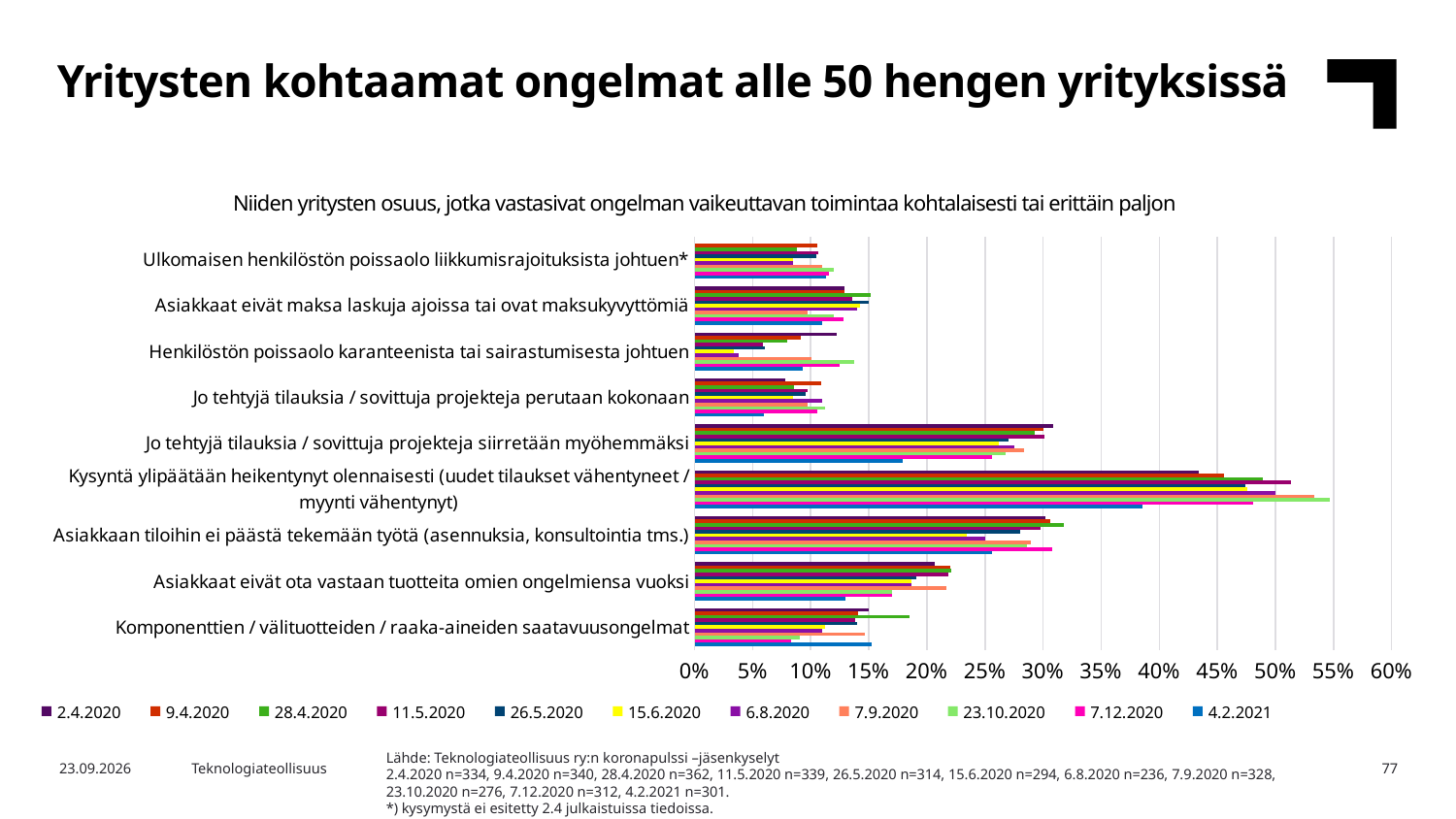
Is the value for 'Asiakkaat eivät ota vastaan tuotteita omien ongelmiensa vuoksi' on 2.4.2020 greater or less than 25%? less Is the value for 'Kysyntä ylipäätään heikentynyt olennaisesti' on 23.10.2020 greater or less than 50%? greater How many survey dates (series) does the legend list? 11 What kind of chart is shown on the slide? Bar chart For 4.2.2021, which is larger: the value for 'Kysyntä ylipäätään heikentynyt olennaisesti' or for 'Komponenttien / välituotteiden / raaka-aineiden saatavuusongelmat'? Kysyntä ylipäätään heikentynyt olennaisesti Which survey date is the first entry in the chart legend? 2.4.2020 Is the value for 'Jo tehtyjä tilauksia / sovittuja projekteja siirretään myöhemmäksi' on 2.4.2020 greater or less than 25%? greater How many problem categories are listed on the chart's vertical axis? 9 What is the highest value shown on the chart's horizontal axis? 60% Which problem category has the highest values across the survey dates? Kysyntä ylipäätään heikentynyt olennaisesti (uudet tilaukset vähentyneet / myynti vähentynyt)